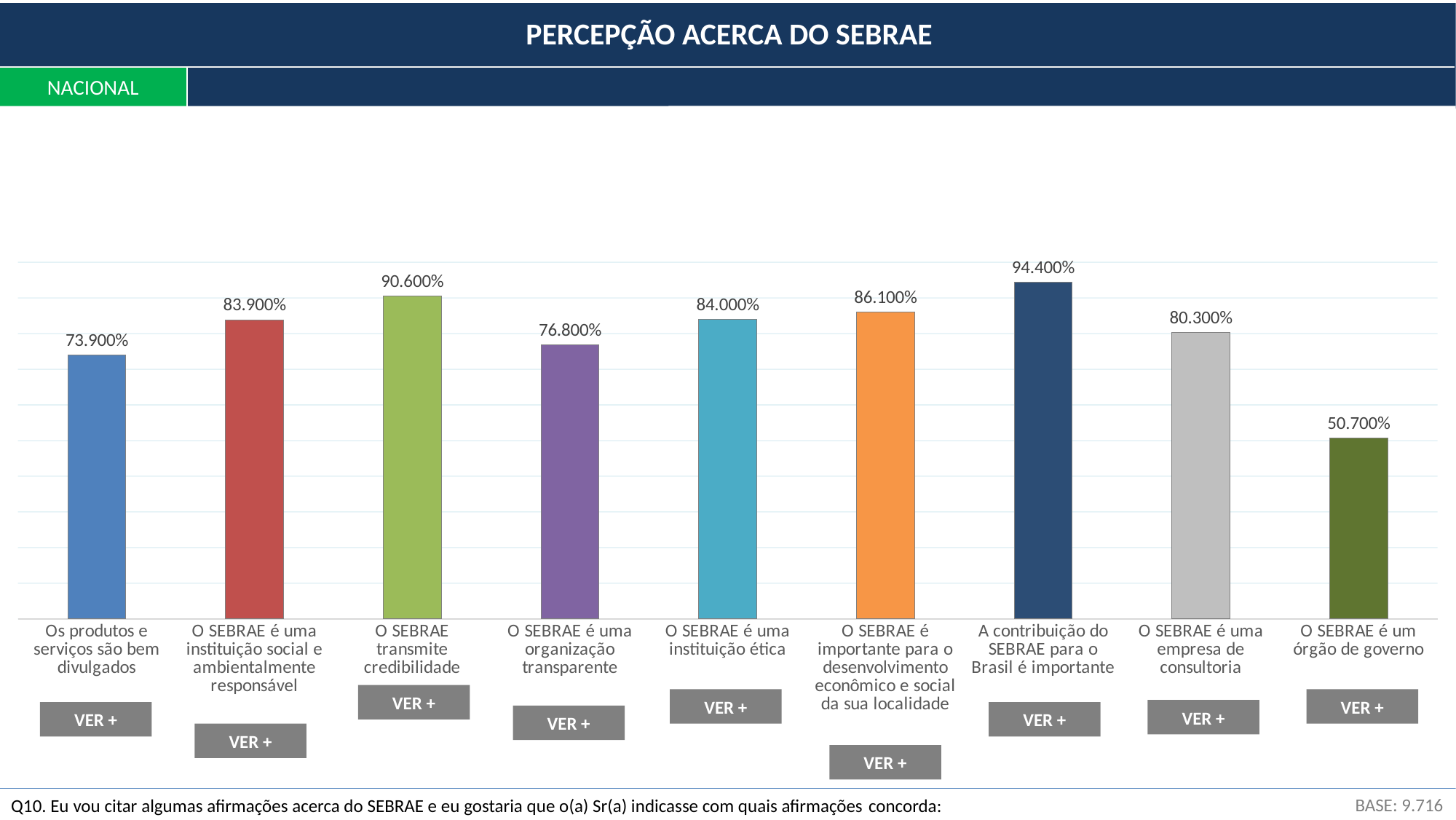
What kind of chart is shown on the slide? Bar chart What value is shown for "Os produtos e serviços são bem divulgados"? 73.900% What value is shown for "O SEBRAE é um órgão de governo"? 50.700% Which is larger: the value for "O SEBRAE é uma organização transparente" or the value for "O SEBRAE é uma instituição ética"? O SEBRAE é uma instituição ética Which statement has the highest value in the chart? A contribuição do SEBRAE para o Brasil é importante What is the difference between the highest value (94.400%) and the lowest value (50.700%)? 43.700 percentage points What value is shown for "O SEBRAE é uma empresa de consultoria"? 80.300% How many statements (bars) are shown in the chart? 9 What value is shown for "O SEBRAE transmite credibilidade"? 90.600% What is the title of the slide containing the chart? PERCEPÇÃO ACERCA DO SEBRAE Which statement has the lowest value in the chart? O SEBRAE é um órgão de governo What is the difference between the values for "O SEBRAE transmite credibilidade" and "Os produtos e serviços são bem divulgados"? 16.700 percentage points